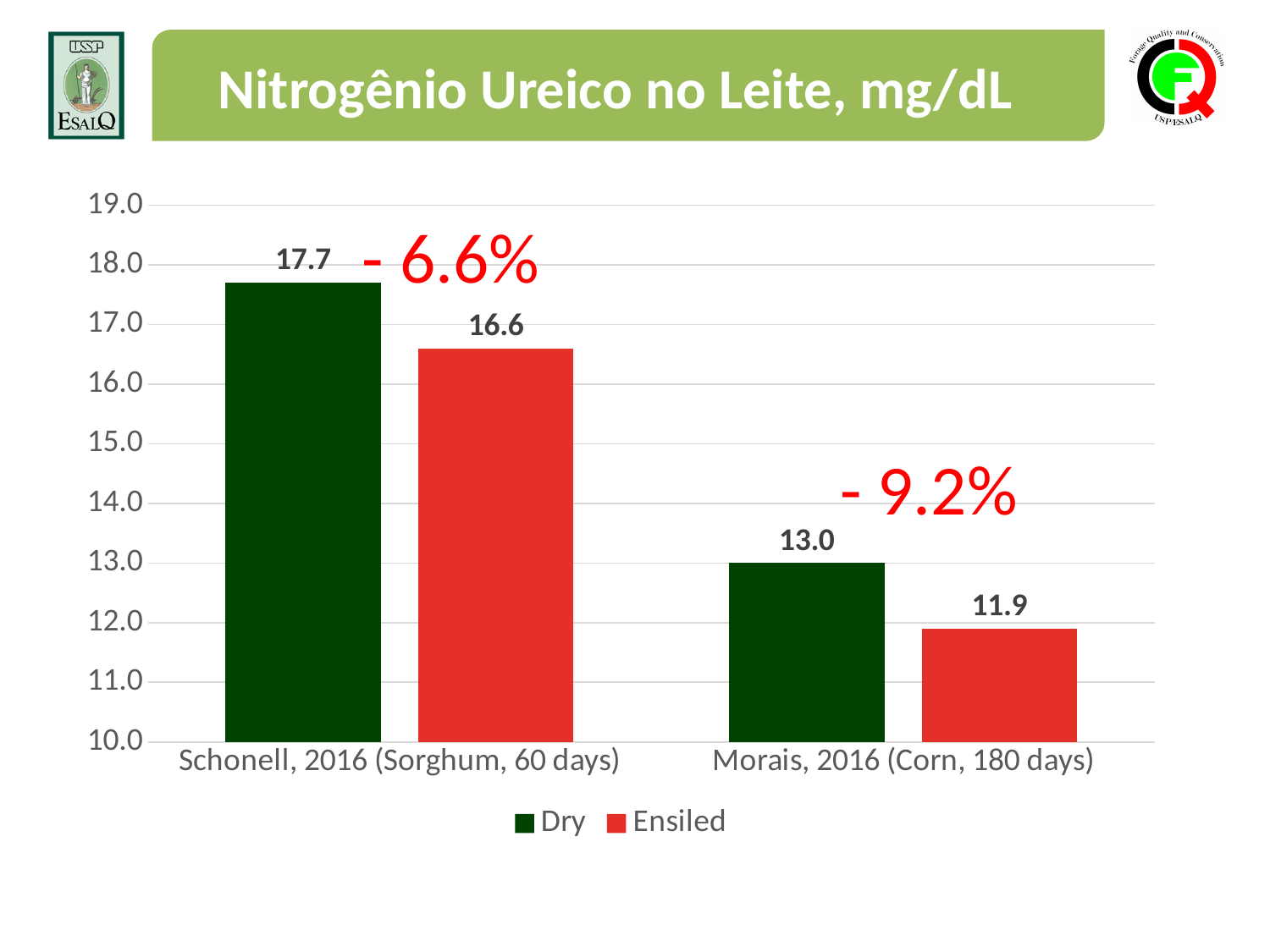
What is the Ensiled value for Schonell, 2016 (Sorghum, 60 days)? 16.6 Which category has the lowest Ensiled value? Morais, 2016 (Corn, 180 days) How many categories are shown on the x axis? 2 What is the Dry value for Schonell, 2016 (Sorghum, 60 days)? 17.7 Which category has the highest Dry value? Schonell, 2016 (Sorghum, 60 days) Which is larger for Schonell, 2016 (Sorghum, 60 days): the Dry value or the Ensiled value? Dry What kind of chart is shown on the slide? bar chart What is the Ensiled value for Morais, 2016 (Corn, 180 days)? 11.9 What percentage change is annotated above the Morais, 2016 (Corn, 180 days) bars? - 9.2% Is the Dry value for Morais, 2016 (Corn, 180 days) greater or less than 14.0? less What is the difference between the Dry and Ensiled values for Morais, 2016 (Corn, 180 days)? 1.1 How many series does the legend list? 2